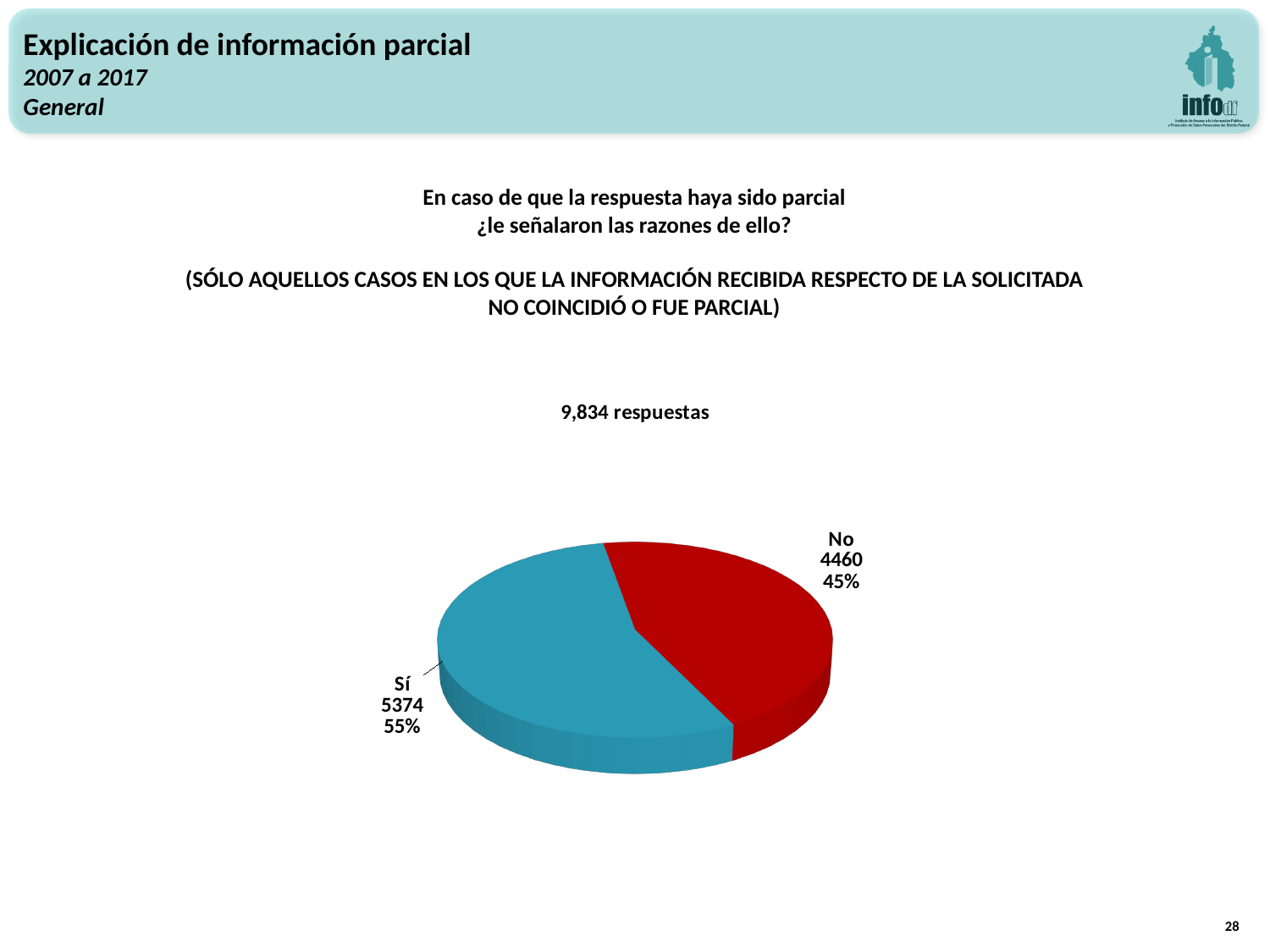
What is the difference between the "Sí" and "No" values? 914 What share of the pie does the "No" slice represent? 45% Which slice is the largest? Sí What is the value for the "No" slice? 4460 How many total responses does the slide report for the chart? 9,834 respuestas Which slice is the smallest? No What share of the pie does the "Sí" slice represent? 55% What colour is the "No" slice? Red What is the value for the "Sí" slice? 5374 Which is larger, the value for "Sí" or the value for "No"? Sí How many slices does the pie chart have? 2 What kind of chart is shown on the slide? Pie chart